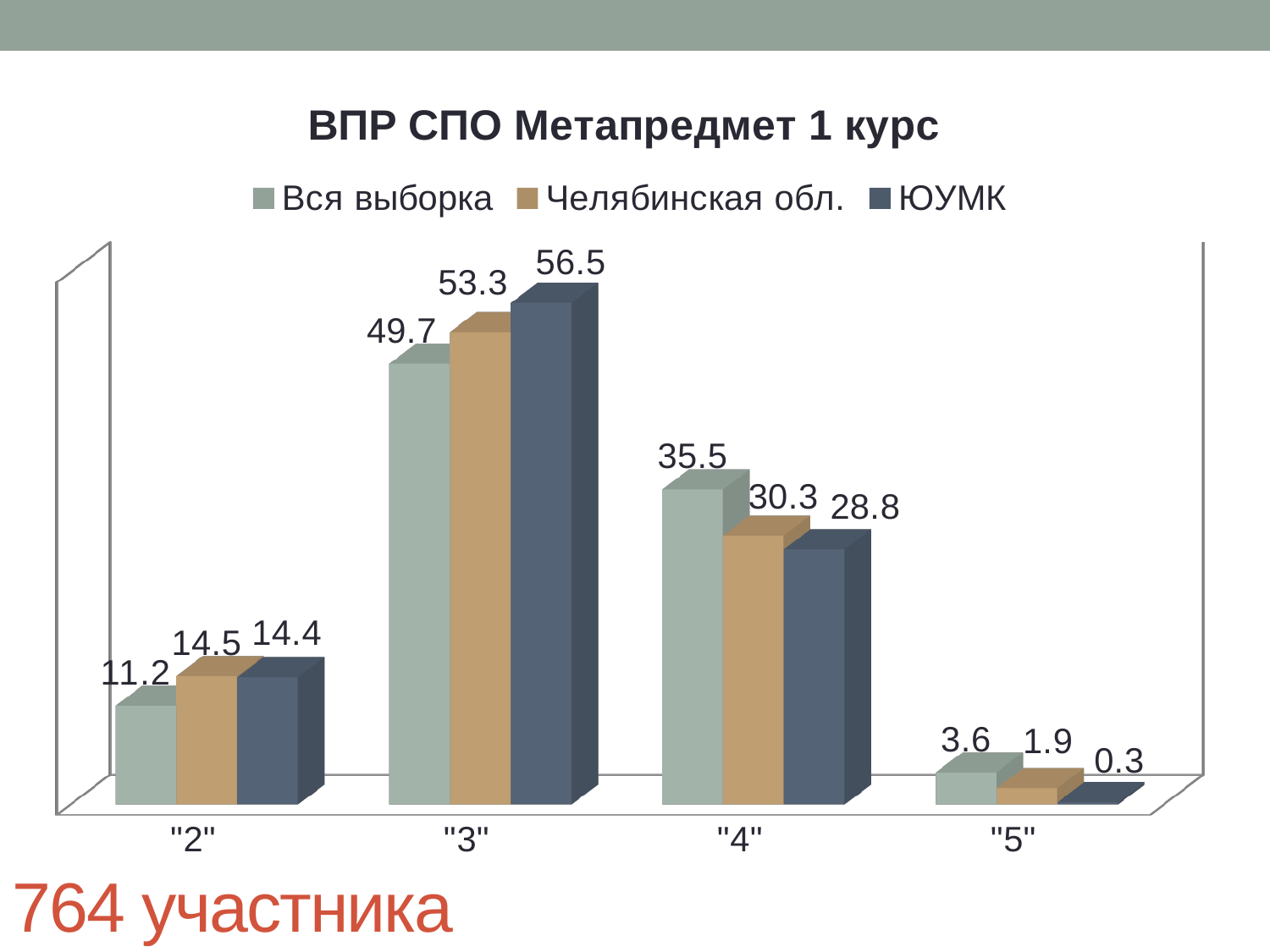
Which category has the lowest value for the ЮУМК series? "5" What is the value for Вся выборка in category "4"? 35.5 What is the value for ЮУМК in category "3"? 56.5 How many series does the legend list? 3 In category "4", which series has the larger value: Челябинская обл. or ЮУМК? Челябинская обл. What kind of chart is shown on the slide? Bar chart Which category has the highest value for the Вся выборка series? "3" How many categories are shown on the x axis? 4 What is the difference between the ЮУМК and Вся выборка values in category "3"? 6.8 What is the value for Челябинская обл. in category "2"? 14.5 What is the difference between the Вся выборка and Челябинская обл. values in category "5"? 1.7 What is the title of the chart? ВПР СПО Метапредмет 1 курс